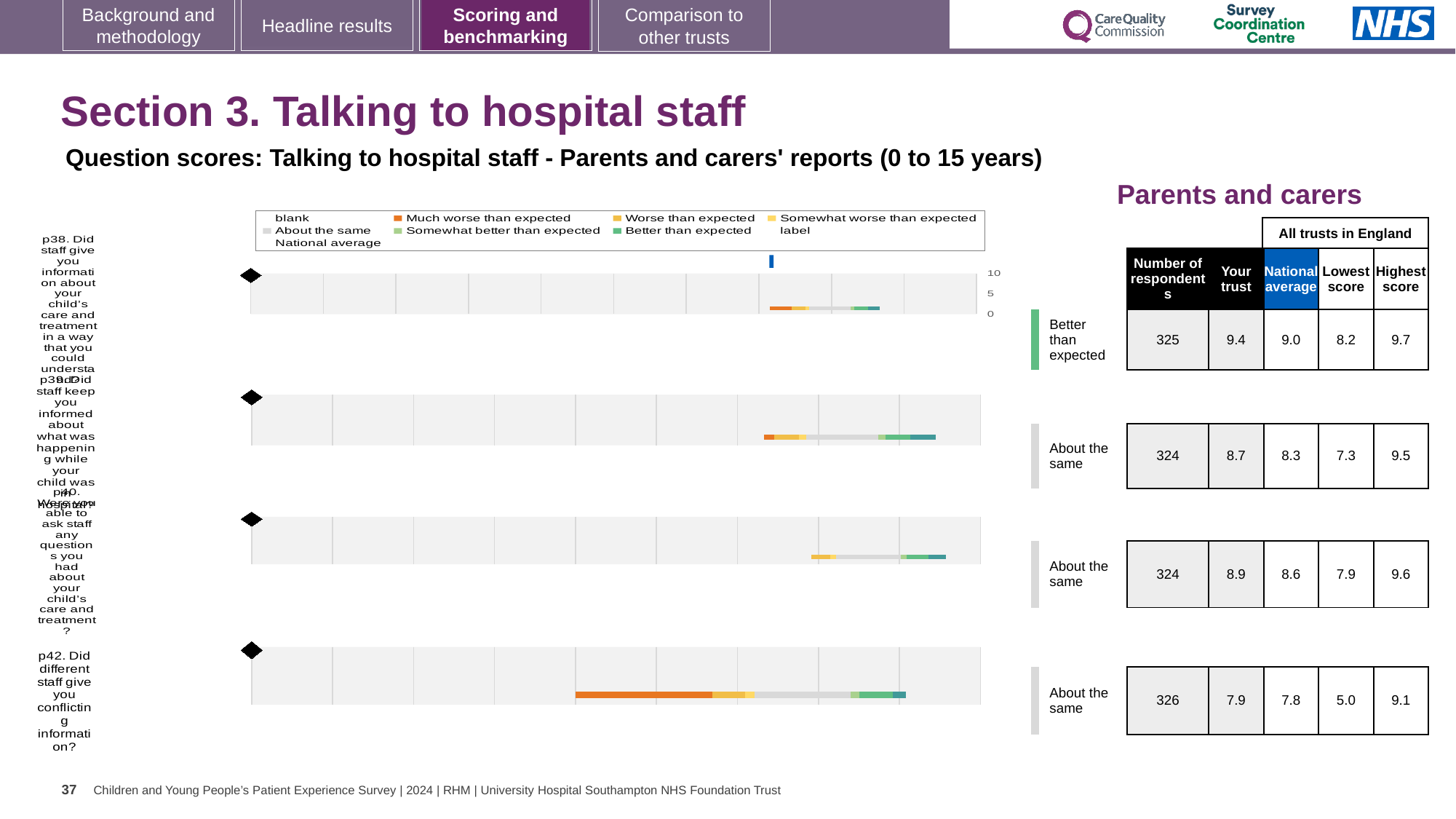
How many respondents answered p39 (Did staff keep you informed about what was happening while your child was in hospital)? 324 Which legend entry is shown in orange? Much worse than expected Which question has the lowest 'Your trust' score? p42 What is the difference between the 'Your trust' score and the national average for p38? 0.4 Which question has the highest 'Your trust' score? p38 For p39, which is larger: the 'Your trust' score or the national average? Your trust What is the lowest score across all trusts in England for p42? 5.0 How many survey questions (rows) are plotted in the chart? 4 What kind of chart is shown on the left of the slide? bar chart What benchmark category is shown for p38 (Did staff give you information about your child's care and treatment in a way that you could understand)? Better than expected What is the national average score for p42 (Did different staff give you conflicting information)? 7.8 What is the 'Your trust' score for p38? 9.4